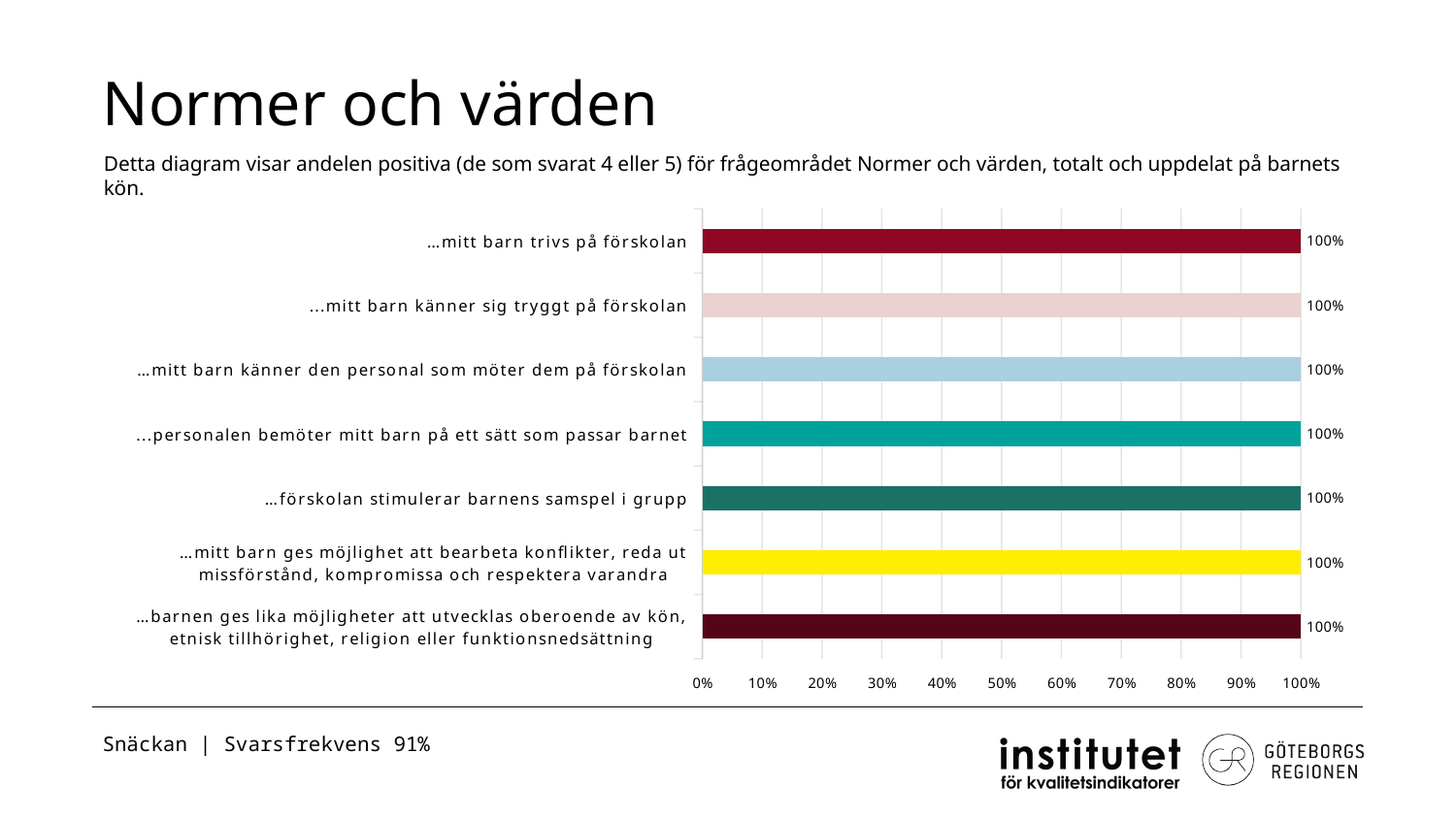
What is the difference between the values for "…mitt barn trivs på förskolan" and "…mitt barn känner den personal som möter dem på förskolan"? 0% What is the value for "…mitt barn trivs på förskolan"? 100% What is the value for "…förskolan stimulerar barnens samspel i grupp"? 100% What is the highest value shown on the x axis? 100% What kind of chart is shown on the slide? Bar chart How many categories are shown in the chart? 7 What is the value for "…barnen ges lika möjligheter att utvecklas oberoende av kön, etnisk tillhörighet, religion eller funktionsnedsättning"? 100% Is the value for "…mitt barn ges möjlighet att bearbeta konflikter, reda ut missförstånd, kompromissa och respektera varandra" greater or less than 90%? greater What is the value for "…personalen bemöter mitt barn på ett sätt som passar barnet"? 100% What is the title of the slide containing the chart? Normer och värden What is the value for "…mitt barn känner sig tryggt på förskolan"? 100%